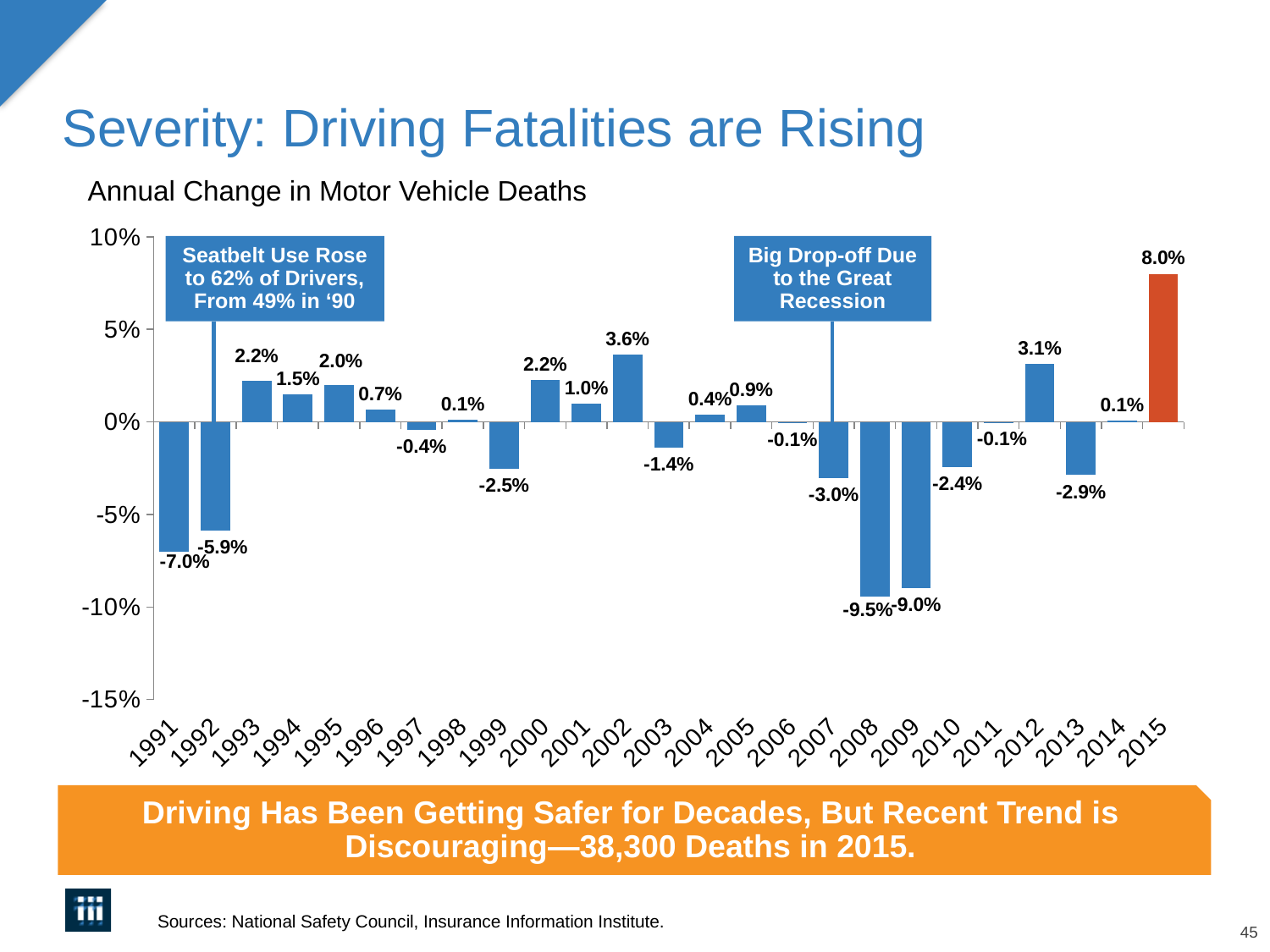
What is the annual change in motor vehicle deaths for 2002? 3.6% What is the annual change in motor vehicle deaths for 1991? -7.0% What is the annual change in motor vehicle deaths for 2008? -9.5% Which year shows the largest annual decrease in motor vehicle deaths? 2008 How many years are shown on the x axis of the chart? 25 What is the annual change in motor vehicle deaths for 2015? 8.0% Which year had a larger annual change in motor vehicle deaths, 2012 or 2013? 2012 What does the callout box above the 2007 bar attribute the big drop-off to? The Great Recession What is the difference in percentage points between the 2015 value (8.0%) and the 2012 value (3.1%)? 4.9 percentage points Is the value for 2009 greater or less than -5%? less What type of chart is used to show the annual change in motor vehicle deaths? Bar chart Which year shows the largest annual increase in motor vehicle deaths? 2015